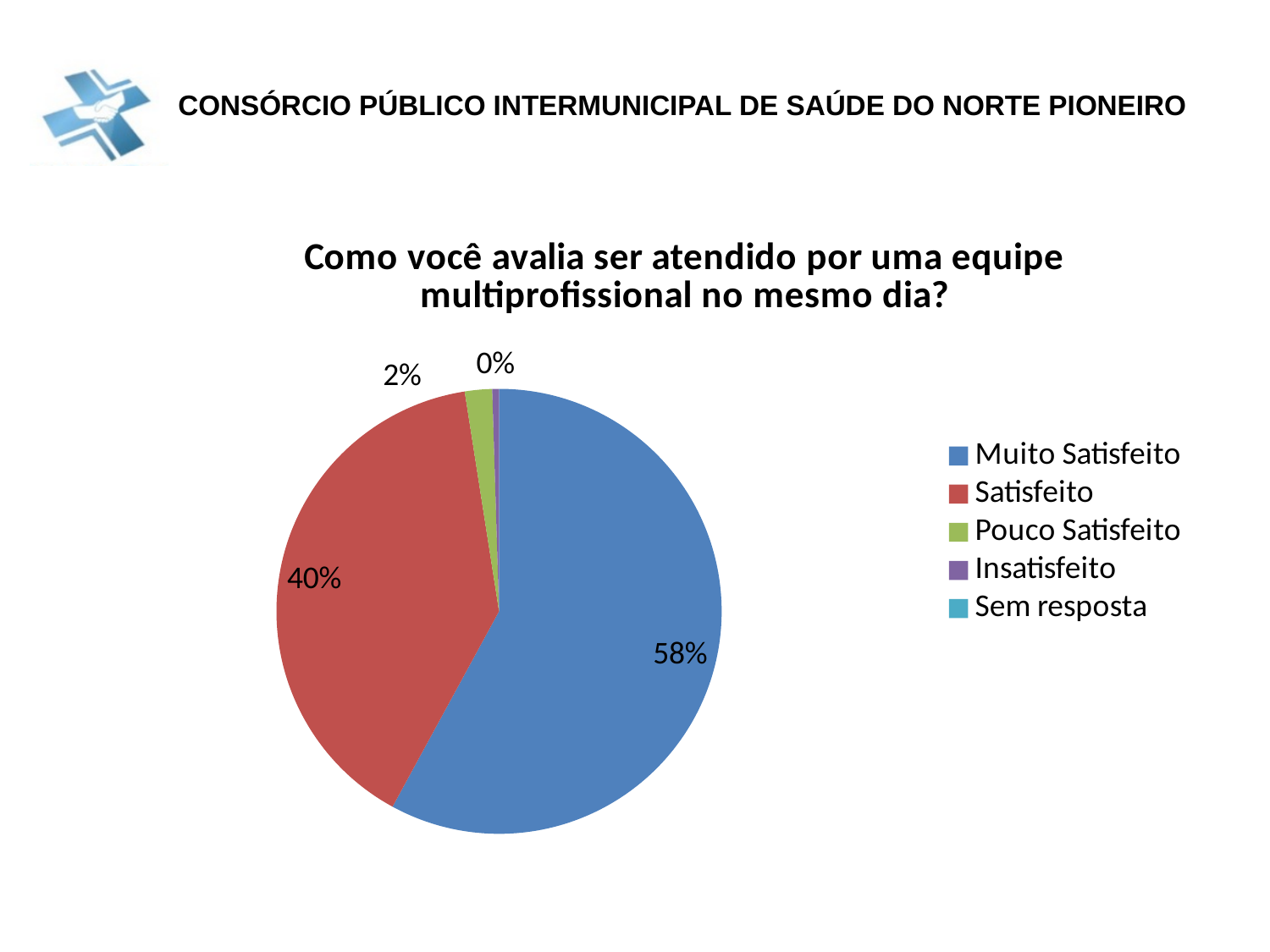
What is the combined percentage of "Muito Satisfeito" and "Satisfeito" responses? 98% What is the difference in percentage points between "Muito Satisfeito" and "Satisfeito"? 18 percentage points Which response category has the largest slice of the pie? Muito Satisfeito Which is larger, the share for "Satisfeito" or the share for "Pouco Satisfeito"? Satisfeito What is the title of the chart? Como você avalia ser atendido por uma equipe multiprofissional no mesmo dia? What percentage of respondents answered "Satisfeito"? 40% What share of the pie does the "Muito Satisfeito" slice represent? 58% How many categories does the legend list? 5 What kind of chart is shown on the slide? Pie chart What percentage of respondents answered "Pouco Satisfeito"? 2% What percentage of respondents answered "Muito Satisfeito"? 58% What colour is the "Satisfeito" slice in the pie chart? Red